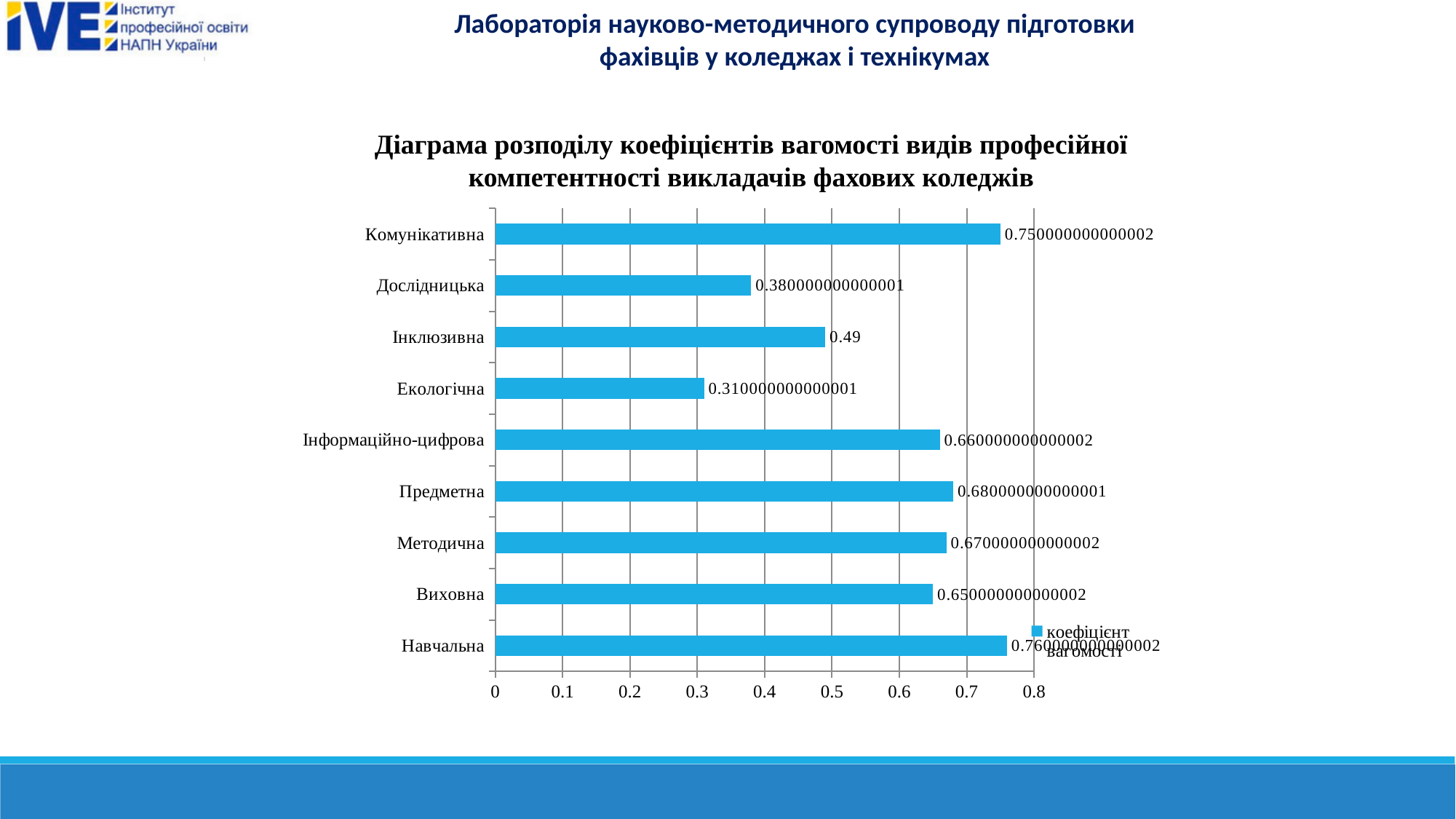
What value is shown for Інклюзивна? 0.49 What value is shown for Предметна? 0.680000000000001 What value is shown for Екологічна? 0.310000000000001 Which category has the lowest value? Екологічна What kind of chart is shown on the slide? bar chart How many categories are shown on the chart? 9 What value is shown for Комунікативна? 0.750000000000002 Is the value for Виховна greater or less than 0.5? greater Which is larger, the value for Дослідницька or the value for Інклюзивна? Інклюзивна What is the legend entry of the chart? коефіцієнт вагомості How many series does the legend list? 1 Which category has the highest value? Навчальна